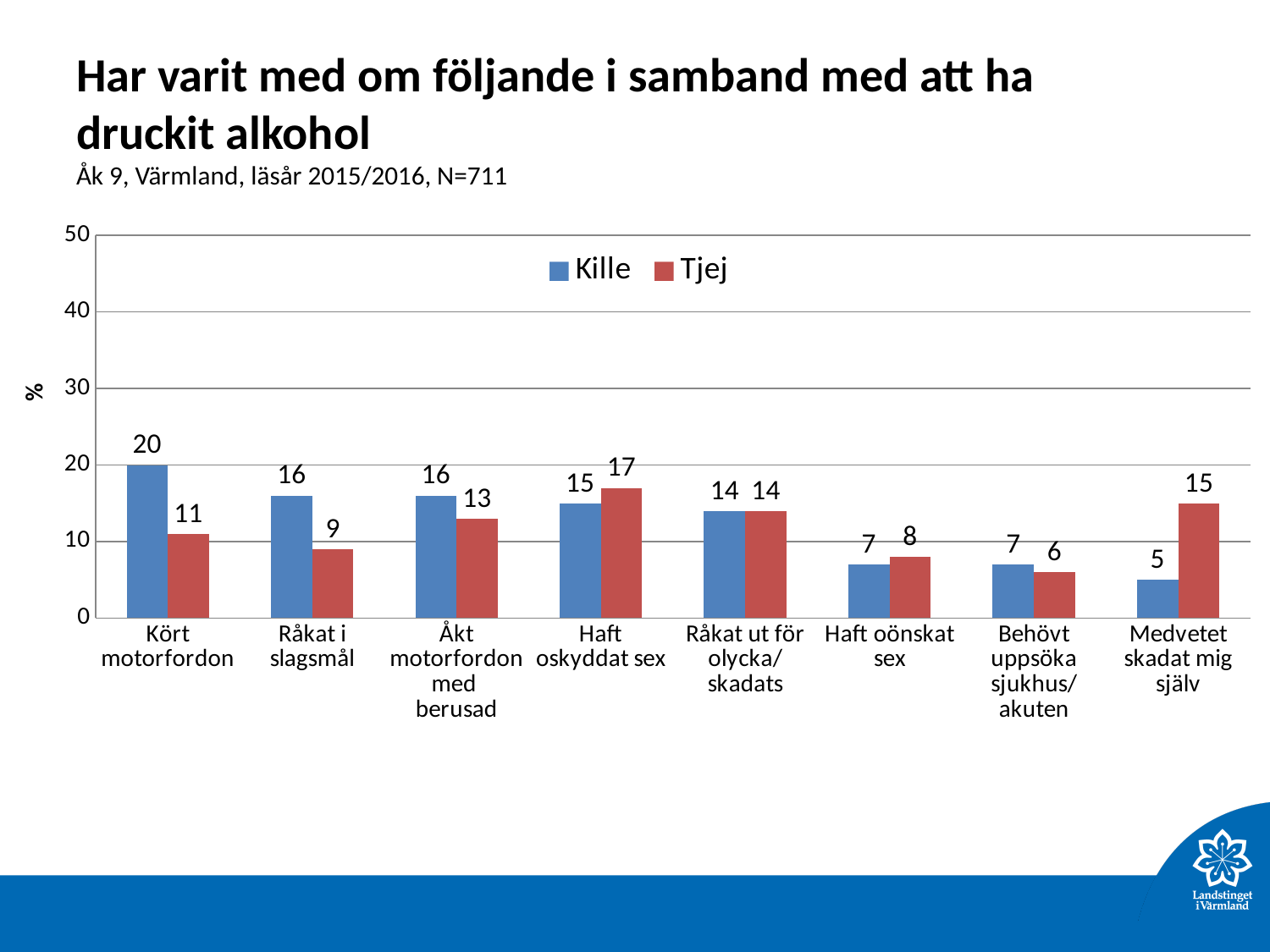
Which category has the lowest value for Kille? Medvetet skadat mig själv What is the value for Tjej for "Råkat i slagsmål"? 9 What is the value for Kille for "Kört motorfordon"? 20 For "Haft oskyddat sex", which series has the larger value, Kille or Tjej? Tjej Which category has the highest value for Kille? Kört motorfordon How many categories are shown on the x axis? 8 What kind of chart is shown on the slide? bar chart Is the value for Kille for "Kört motorfordon" greater or less than 10? greater Which category has the lowest value for Tjej? Behövt uppsöka sjukhus/akuten How many series does the legend list? 2 What is the value for Tjej for "Medvetet skadat mig själv"? 15 What is the difference between Kille and Tjej for "Kört motorfordon"? 9